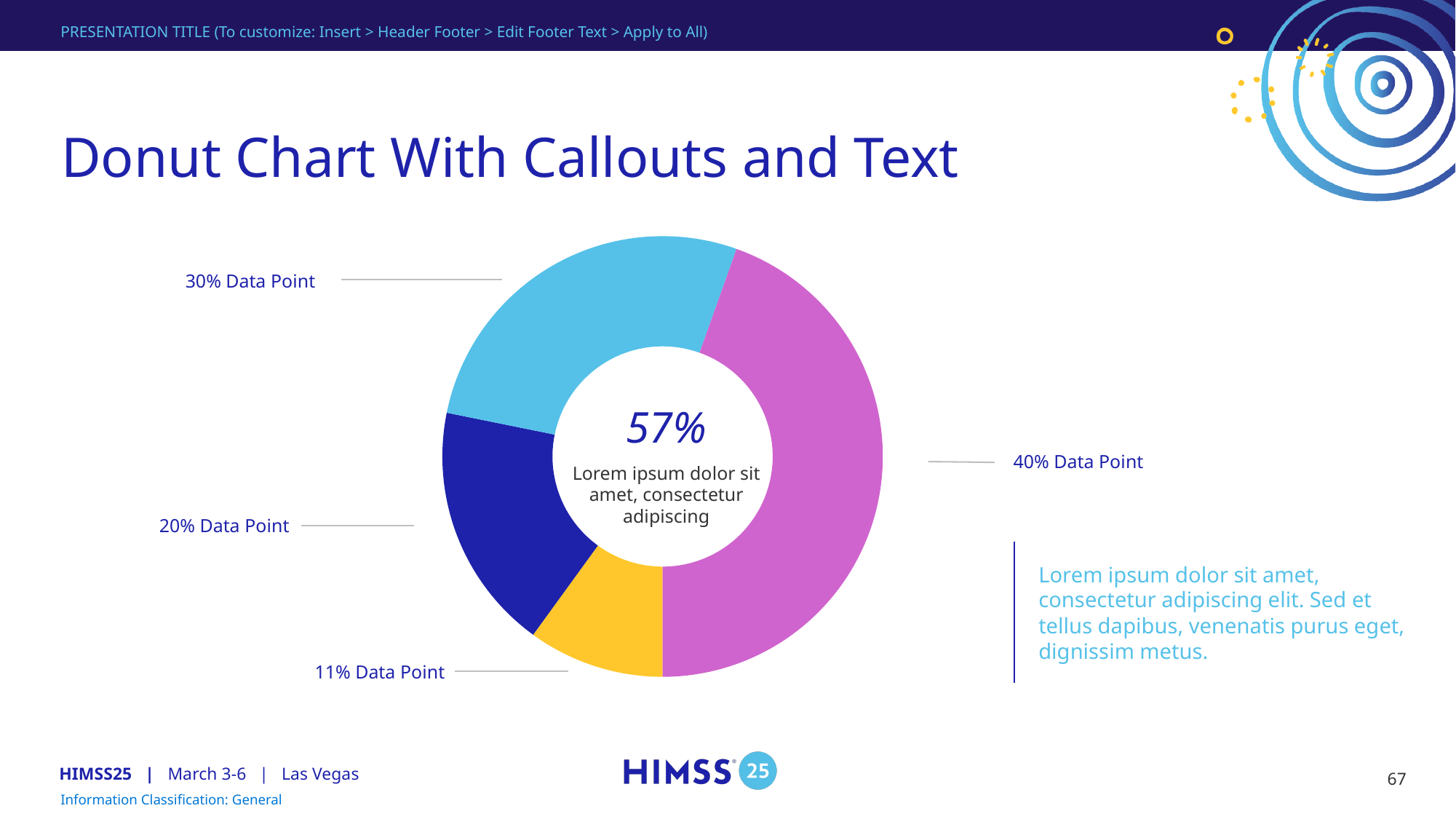
What is the title of the slide containing the donut chart? Donut Chart With Callouts and Text What percentage is shown for the magenta slice of the donut chart? 40% What percentage is shown for the yellow slice of the donut chart? 11% What kind of chart is shown on the slide? Donut chart What is the combined share of the 30% Data Point and 20% Data Point slices? 50% What percentage is shown for the light blue slice of the donut chart? 30% What large value is printed in the centre of the donut chart? 57% What is the difference between the largest slice (40% Data Point) and the 30% Data Point slice? 10% Which slice of the donut chart is the largest? 40% Data Point Which slice of the donut chart is the smallest? 11% Data Point How many slices does the donut chart have? 4 Which is larger, the 30% Data Point slice or the 20% Data Point slice? 30% Data Point